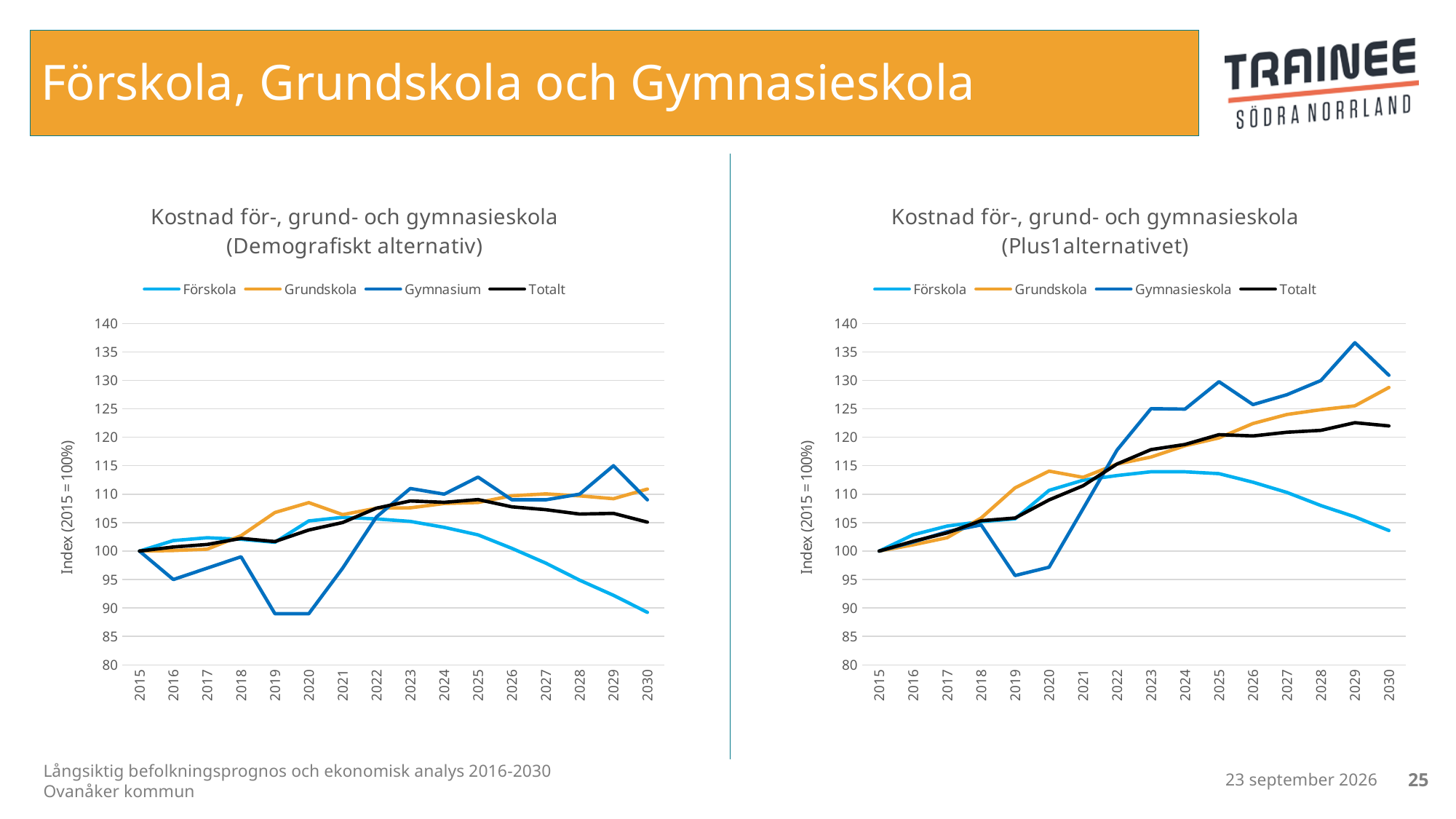
In the left chart (Demografiskt alternativ), what is the index value for Totalt in 2015? 100 In the right chart (Plus1alternativet), which is larger in 2030, Grundskola or Totalt? Grundskola In the left chart (Demografiskt alternativ), which series has the lowest value in 2019? Gymnasium In the left chart (Demografiskt alternativ), is the value for Gymnasium in 2019 greater or less than 95? less In the left chart (Demografiskt alternativ), which is larger in 2019, Grundskola or Gymnasium? Grundskola In the right chart (Plus1alternativet), which series has the highest value in 2029? Gymnasieskola In the right chart (Plus1alternativet), is the value for Gymnasieskola in 2029 greater or less than 130? greater How many years are shown on the x axis of the left chart (Demografiskt alternativ)? 16 In the right chart (Plus1alternativet), does the Förskola line rise or fall from 2024 to 2030? fall What kind of chart is the left chart (Demografiskt alternativ)? line chart How many series does the legend of the right chart (Plus1alternativet) list? 4 In the left chart (Demografiskt alternativ), is the value for Förskola in 2030 greater or less than 95? less